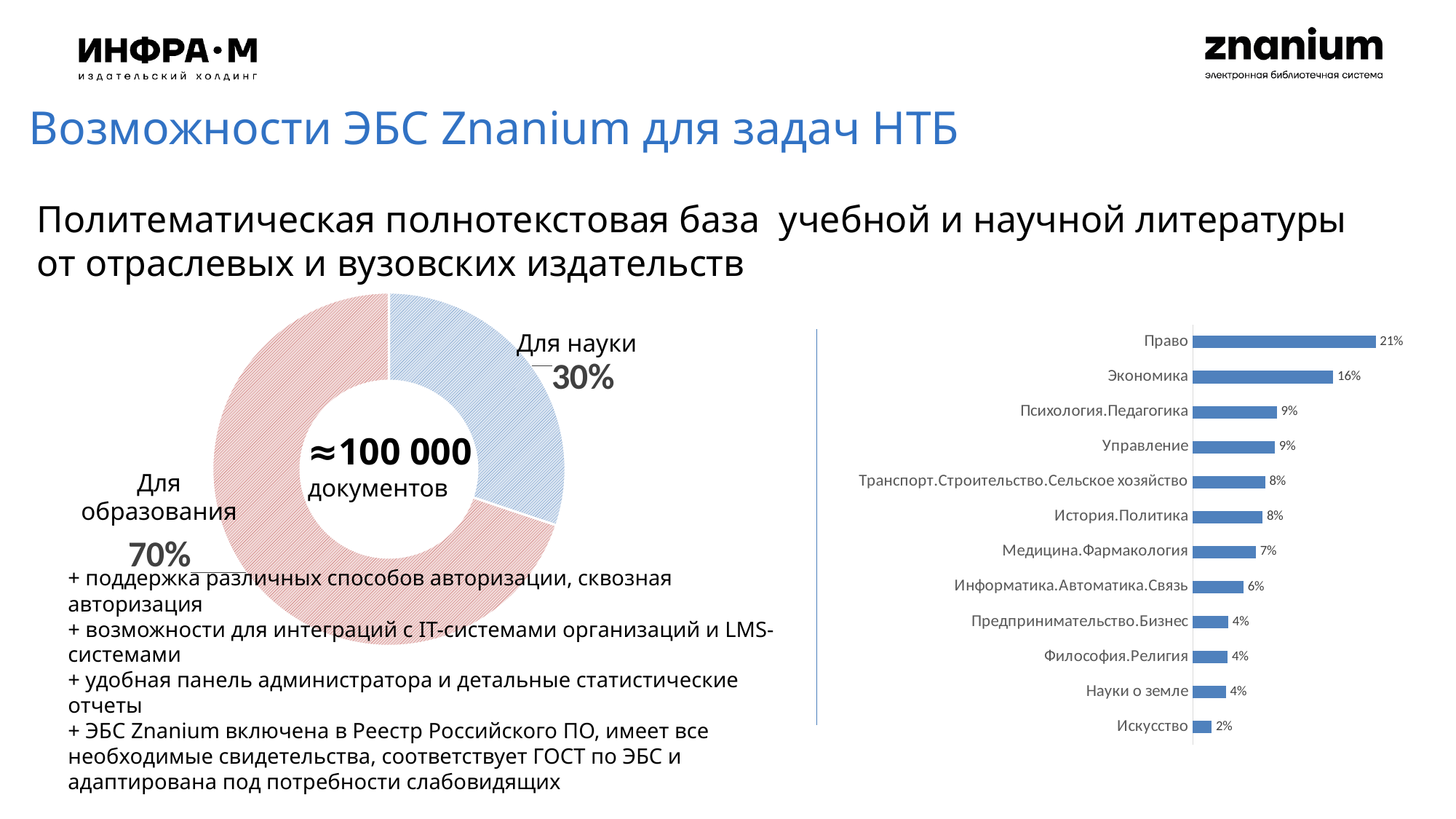
In the donut chart on the left, what share is labelled Для науки? 30% In the donut chart on the left, what share is labelled Для образования? 70% In the bar chart on the right, which is larger: Медицина.Фармакология or Информатика.Автоматика.Связь? Медицина.Фармакология In the bar chart on the right, what is the value for Право? 21% What kind of chart is shown on the right side of the slide? Bar chart In the bar chart on the right, which category has the lowest value? Искусство How many categories are shown in the bar chart on the right? 12 In the bar chart on the right, what is the difference between the values for Право and Экономика? 5 percentage points In the bar chart on the right, what is the value for Экономика? 16% What text is shown in the centre of the donut chart on the left? ≈100 000 документов In the bar chart on the right, which category has the highest value? Право In the donut chart on the left, which segment is larger: Для науки or Для образования? Для образования